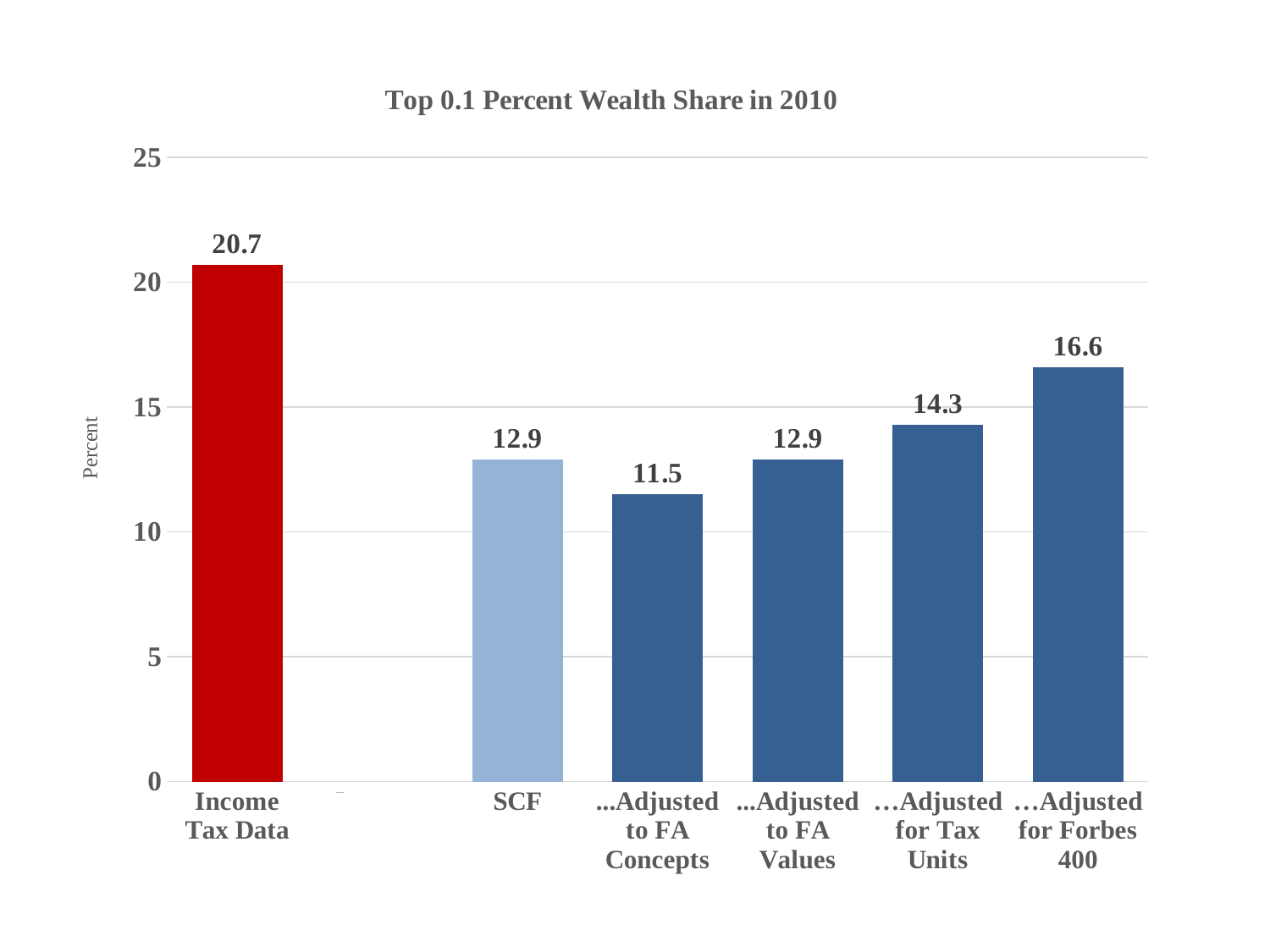
Which category has the lowest value? ...Adjusted to FA Concepts What is the value for the bar labelled ...Adjusted for Tax Units? 14.3 Which category has the highest value? Income Tax Data What is the value for the bar labelled ...Adjusted for Forbes 400? 16.6 What is the value for the SCF bar? 12.9 Which is larger, the value for ...Adjusted for Tax Units or the value for ...Adjusted to FA Values? ...Adjusted for Tax Units What is the difference between the Income Tax Data value and the ...Adjusted for Forbes 400 value? 4.1 What is the title of the chart? Top 0.1 Percent Wealth Share in 2010 How many bars are plotted on the chart? 6 What is the value for the bar labelled ...Adjusted to FA Concepts? 11.5 What is the value for Income Tax Data? 20.7 What kind of chart is shown? Bar chart